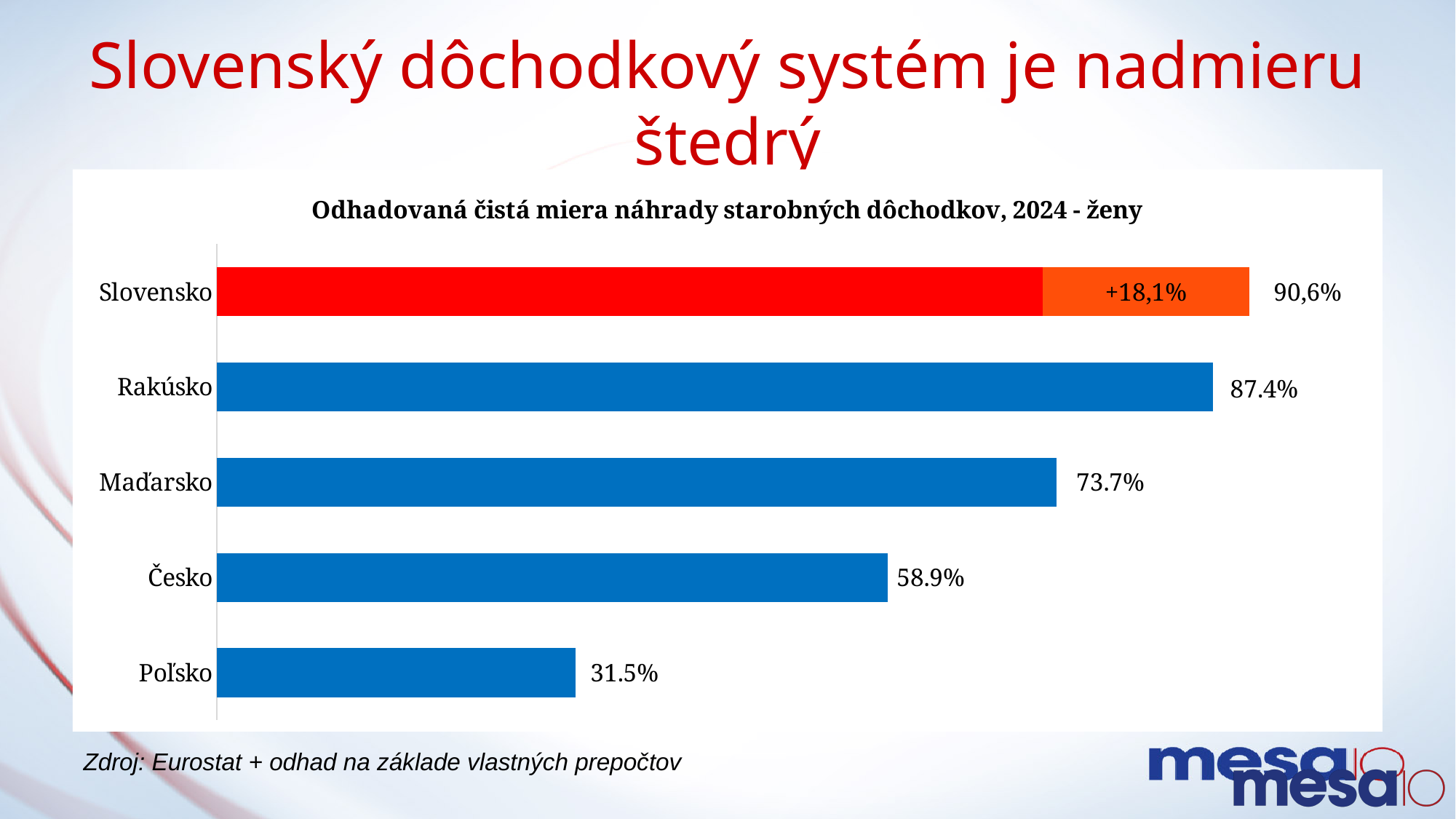
Which country has the lowest value? Poľsko What is the value shown for Poľsko? 31.5% What is the value shown for Rakúsko? 87.4% What is the difference between the values for Česko and Poľsko? 27.4 percentage points What is the value of the orange segment added to the Slovensko bar? +18,1% How many countries are shown in the chart? 5 Which country has the highest value? Slovensko What type of chart is shown? Bar chart What is the difference between the values for Maďarsko and Česko? 14.8 percentage points What is the title of the chart? Odhadovaná čistá miera náhrady starobných dôchodkov, 2024 - ženy What is the total value shown for Slovensko? 90,6% Which has a larger value, Rakúsko or Maďarsko? Rakúsko